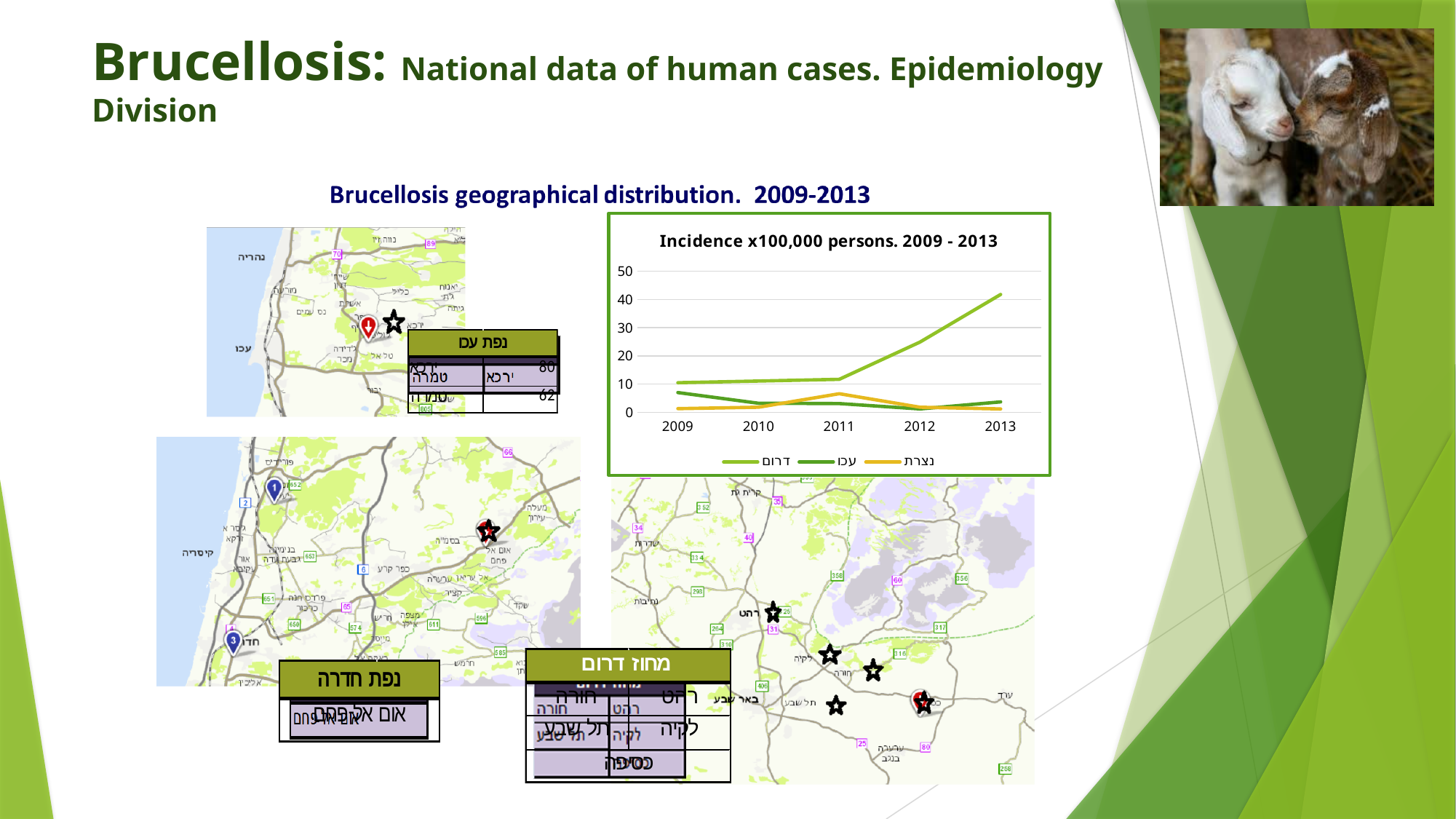
In the incidence chart, is the value for דרום in 2012 greater or less than 20? greater In the incidence chart, is the value for דרום in 2013 greater or less than 40? greater In the incidence chart, which series has the larger value in 2013, דרום or עכו? דרום In the incidence chart, which series has the larger value in 2011, נצרת or עכו? נצרת In the incidence chart, is the value for עכו in 2009 greater or less than 10? less How many years are shown on the x axis of the incidence chart? 5 What is the title of the line chart on the slide? Incidence x100,000 persons. 2009 - 2013 How many series does the legend of the incidence chart list? 3 In the incidence chart, which year has the highest value for the דרום series? 2013 What kind of chart is the 'Incidence x100,000 persons. 2009 - 2013' chart? line chart In the incidence chart, does the דרום series rise or fall from 2011 to 2013? rise